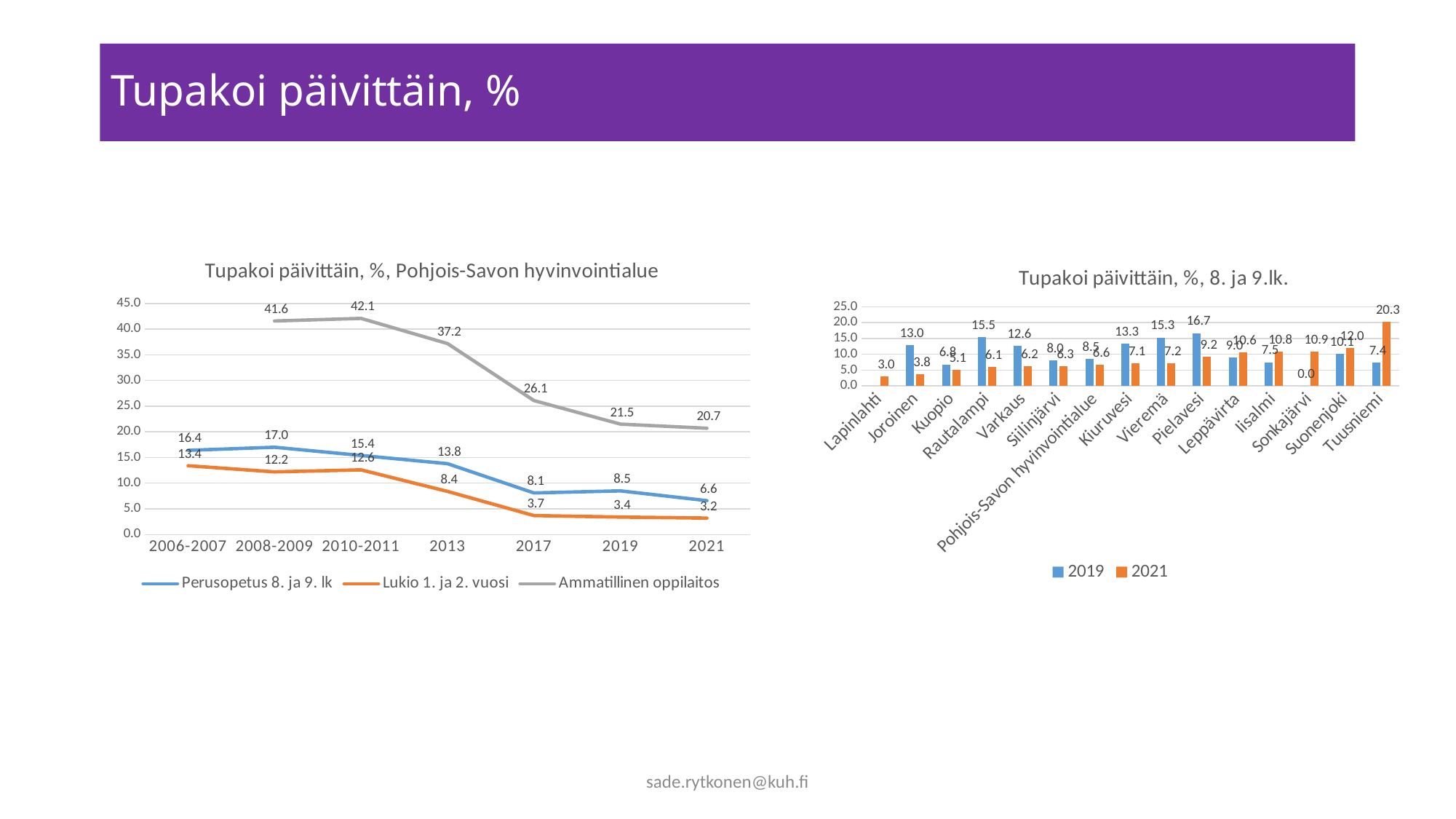
In the chart 'Tupakoi päivittäin, %, Pohjois-Savon hyvinvointialue', what is the value for Lukio 1. ja 2. vuosi in 2021? 3.2 What kind of chart is 'Tupakoi päivittäin, %, 8. ja 9.lk.'? bar chart In the chart 'Tupakoi päivittäin, %, Pohjois-Savon hyvinvointialue', what is the difference between Perusopetus 8. ja 9. lk and Lukio 1. ja 2. vuosi in 2017? 4.4 In the chart 'Tupakoi päivittäin, %, 8. ja 9.lk.', which category has the lowest 2021 value? Lapinlahti In the chart 'Tupakoi päivittäin, %, 8. ja 9.lk.', what is the 2021 value for Tuusniemi? 20.3 In the chart 'Tupakoi päivittäin, %, 8. ja 9.lk.', which municipality has the highest 2019 value? Pielavesi In the chart 'Tupakoi päivittäin, %, Pohjois-Savon hyvinvointialue', how many series does the legend list? 3 In the chart 'Tupakoi päivittäin, %, Pohjois-Savon hyvinvointialue', does the Ammatillinen oppilaitos line rise or fall from 2010-2011 to 2021? fall In the chart 'Tupakoi päivittäin, %, 8. ja 9.lk.', how many categories are shown on the x axis? 15 In the chart 'Tupakoi päivittäin, %, Pohjois-Savon hyvinvointialue', what is the value for Ammatillinen oppilaitos in 2013? 37.2 In the chart 'Tupakoi päivittäin, %, 8. ja 9.lk.', which is larger for Joroinen: the 2019 value or the 2021 value? 2019 What kind of chart is 'Tupakoi päivittäin, %, Pohjois-Savon hyvinvointialue'? line chart